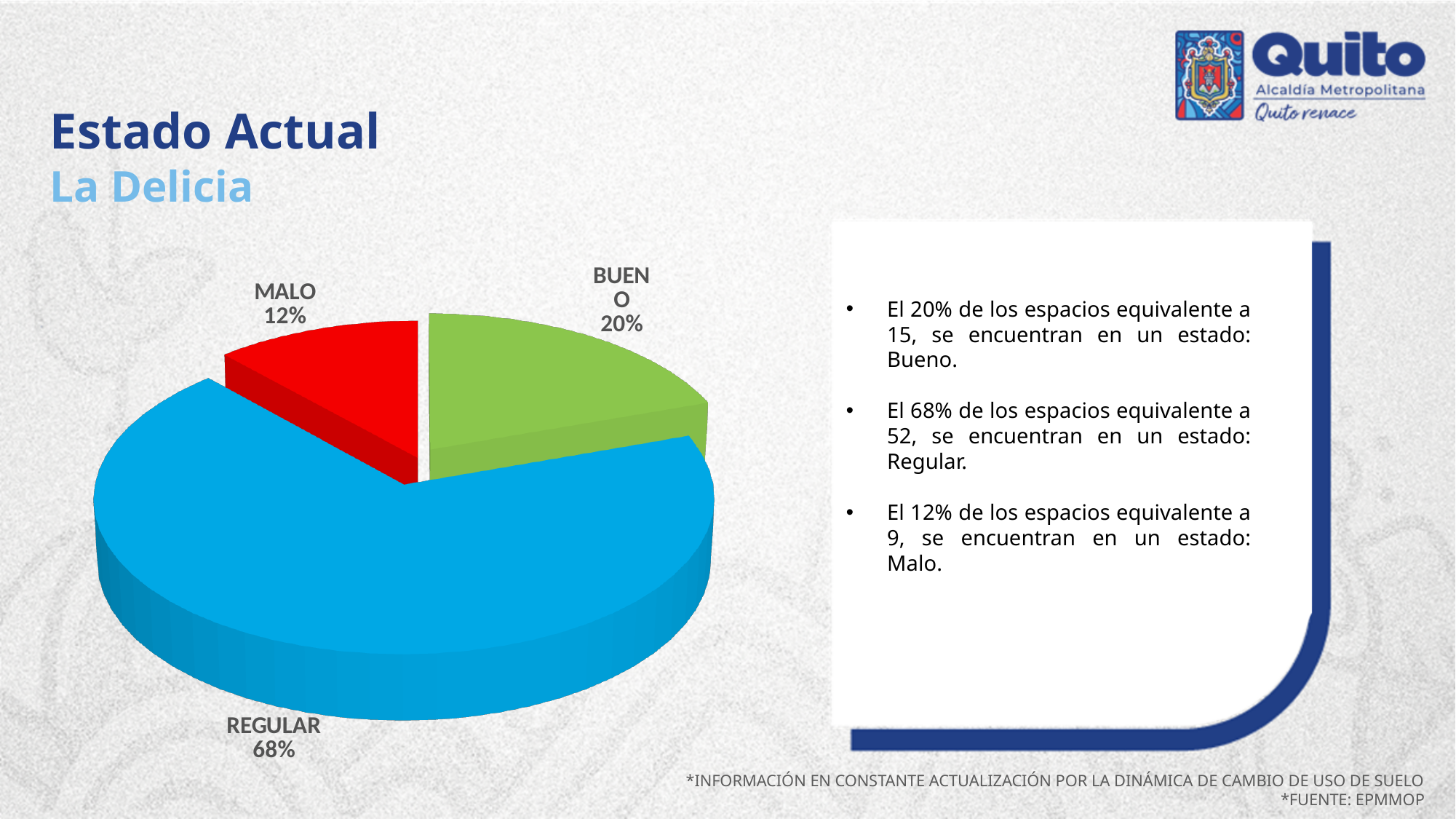
What colour is the MALO slice in the pie chart? Red What colour is the REGULAR slice in the pie chart? Blue What is the difference in percentage points between the REGULAR and BUENO slices? 48 How many slices does the pie chart have? 3 What type of chart is shown on the slide? Pie chart What is the difference in percentage points between the BUENO and MALO slices? 8 What percentage of the pie chart is labelled REGULAR? 68% Which category has the largest slice in the pie chart? REGULAR What percentage of the pie chart is labelled MALO? 12% What percentage of the pie chart is labelled BUENO? 20% Which slice is larger, BUENO or MALO? BUENO Which category has the smallest slice in the pie chart? MALO